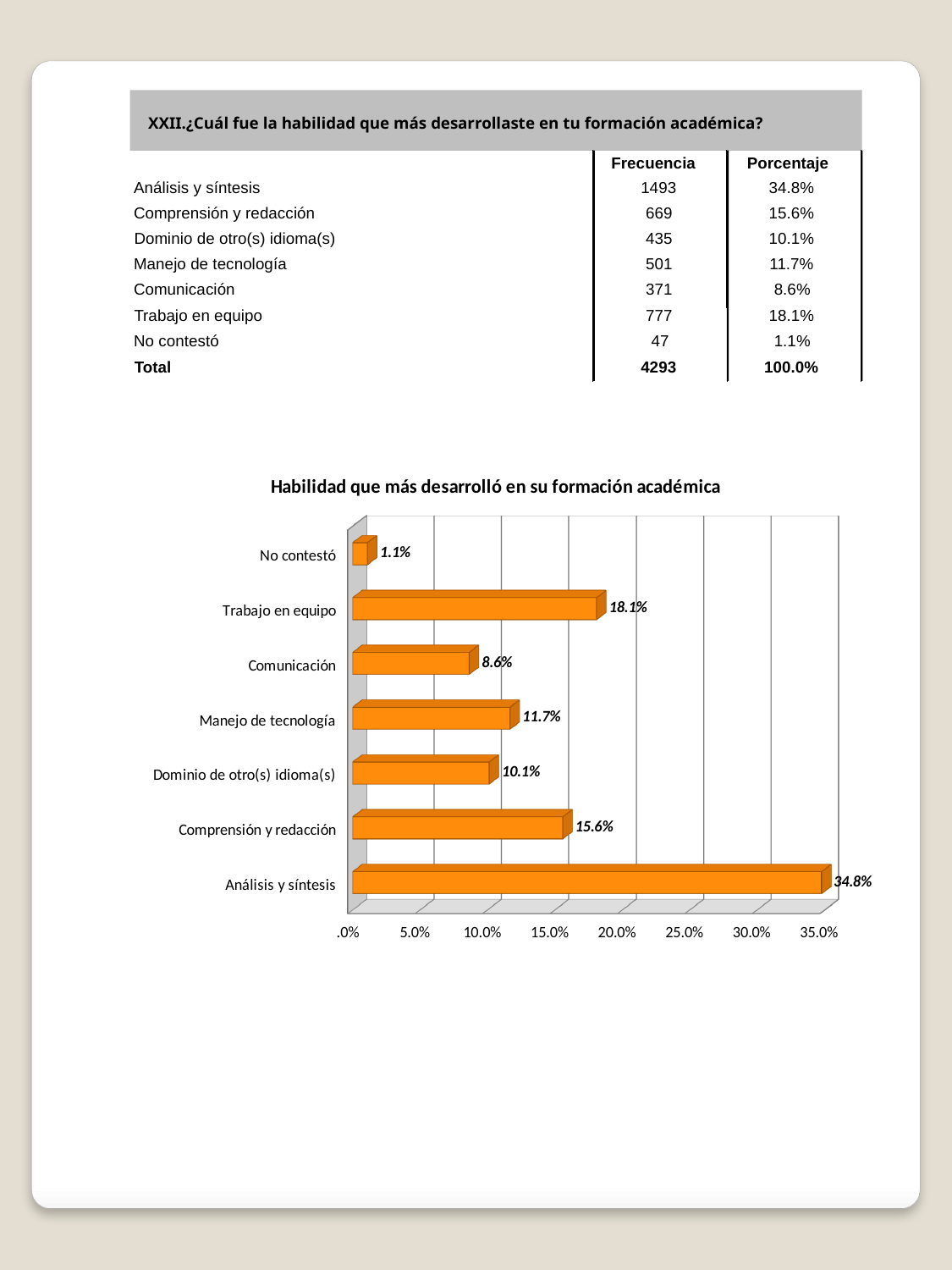
What is the title of the chart? Habilidad que más desarrolló en su formación académica What is the difference between the values for Análisis y síntesis and Comprensión y redacción? 19.2% Which category has the highest value in the chart? Análisis y síntesis Which category has the lowest value in the chart? No contestó What colour are the bars in the chart? Orange What is the value for Dominio de otro(s) idioma(s) in the chart? 10.1% What is the value for Comunicación in the chart? 8.6% What is the value for Trabajo en equipo in the chart? 18.1% What kind of chart is shown on the slide? Bar chart Which is larger, the value for Manejo de tecnología or the value for Comunicación? Manejo de tecnología Is the value for Trabajo en equipo greater or less than 15.0%? greater How many categories are shown in the chart? 7